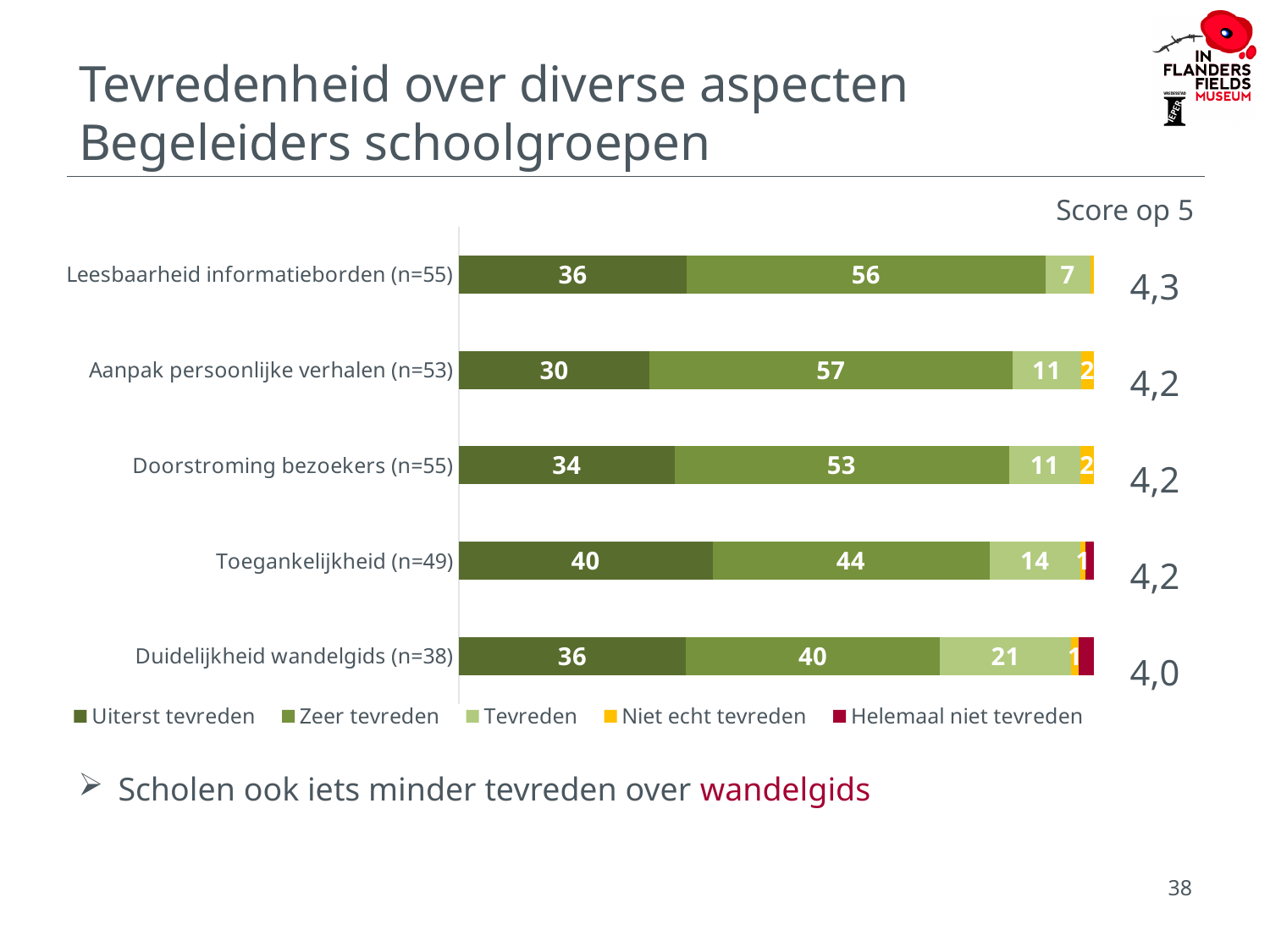
What is the 'Uiterst tevreden' value for Toegankelijkheid (n=49)? 40 How many categories (aspects) are plotted in the chart? 5 What is the 'Score op 5' shown for Leesbaarheid informatieborden (n=55)? 4,3 What kind of chart is shown on the slide? Stacked bar chart How many series does the legend list? 5 Which category has the highest 'Uiterst tevreden' value? Toegankelijkheid (n=49) Which is larger: the 'Tevreden' value for Toegankelijkheid (n=49) or for Doorstroming bezoekers (n=55)? Toegankelijkheid (n=49) Which category has the lowest 'Score op 5'? Duidelijkheid wandelgids (n=38) What is the difference between the 'Zeer tevreden' values for Leesbaarheid informatieborden (n=55) and Duidelijkheid wandelgids (n=38)? 16 What is the 'Tevreden' value for Duidelijkheid wandelgids (n=38)? 21 What is the 'Zeer tevreden' value for Aanpak persoonlijke verhalen (n=53)? 57 Which legend entry is shown in yellow? Niet echt tevreden